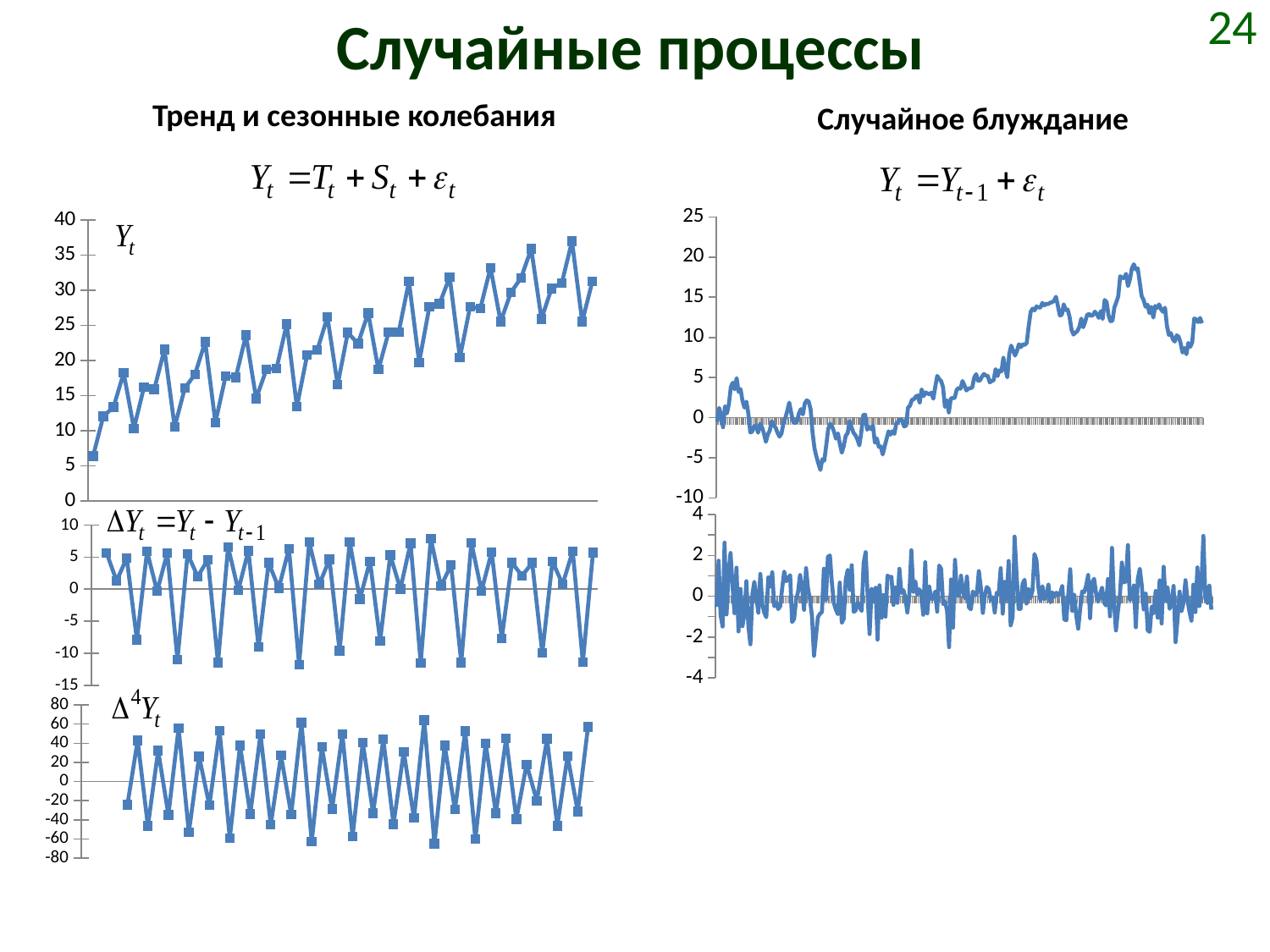
In the top-right random walk chart, is the lowest value greater or less than -5? less In the top-left Y_t chart, do the values overall rise or fall along the x axis? rise In the top-right random walk chart, is the peak value greater or less than 20? less In the top-left Y_t chart, is the highest plotted value greater or less than 35? greater What is the lowest tick shown on the y axis of the middle-left ΔY_t chart? -15 In the bottom-right chart, do the values show an overall rise, an overall fall, or neither along the x axis? neither What is the highest tick shown on the y axis of the bottom-left Δ⁴Y_t chart? 80 What kind of chart is the top-right chart under 'Случайное блуждание'? line chart What kind of chart is the top-left chart labelled Y_t under 'Тренд и сезонные колебания'? line chart